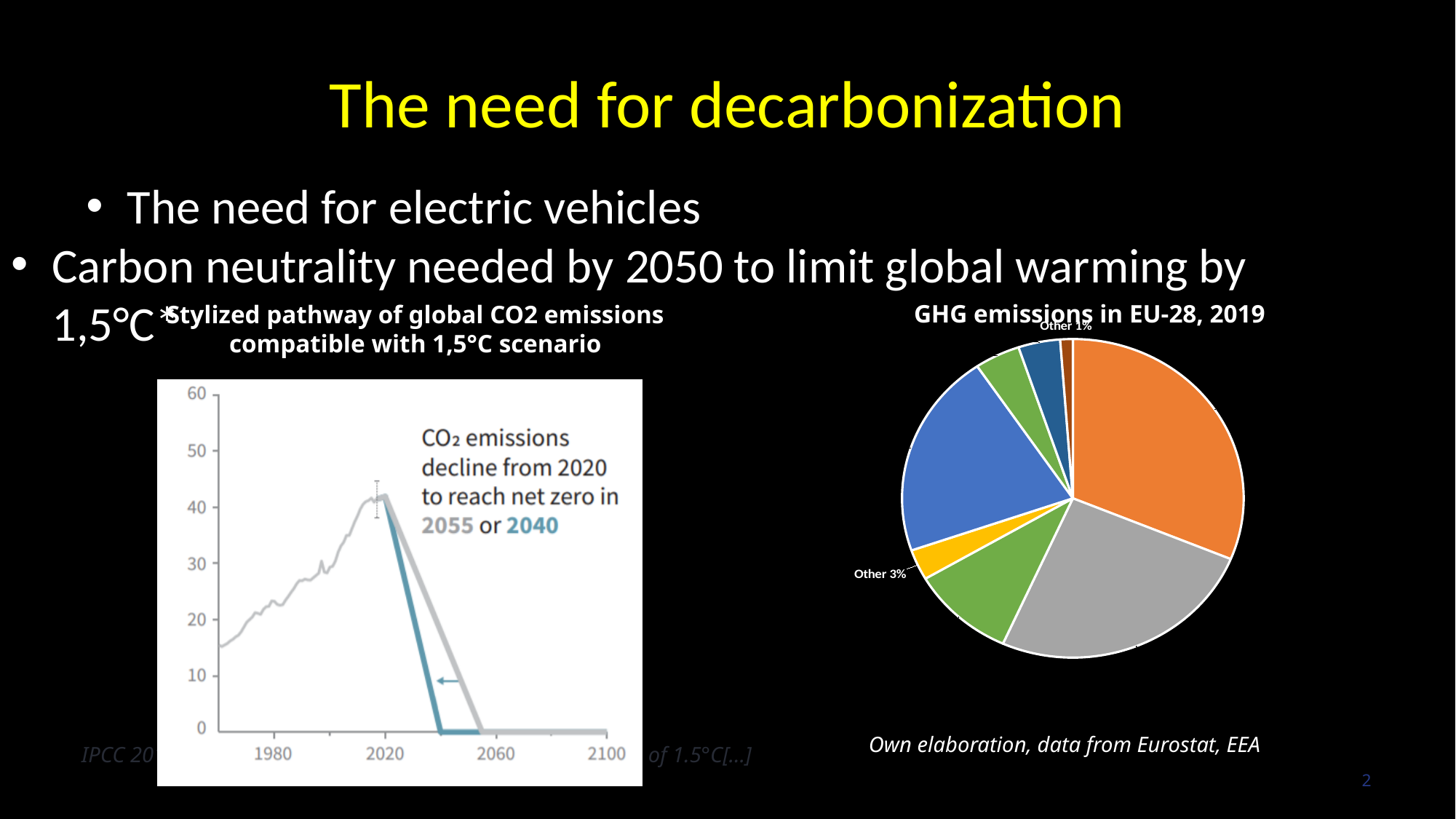
In the 'GHG emissions in EU-28, 2019' pie chart, what share does the slice labelled 'Other 1%' have? 1% In the 'GHG emissions in EU-28, 2019' pie chart, what share does the slice labelled 'Other 3%' have? 3% What kind of chart is the 'Stylized pathway of global CO2 emissions compatible with 1,5°C scenario' chart? line chart In the 'Stylized pathway of global CO2 emissions' chart, in which year does the grey pathway reach net zero? 2055 In the 'GHG emissions in EU-28, 2019' pie chart, which of the two labelled 'Other' slices is larger, the 1% one or the 3% one? Other 3% What kind of chart is the 'GHG emissions in EU-28, 2019' chart? pie chart In the 'Stylized pathway of global CO2 emissions' chart, in which year does the blue pathway reach net zero? 2040 In the 'GHG emissions in EU-28, 2019' pie chart, how many slices are there? 8 In the 'Stylized pathway of global CO2 emissions' chart, is the peak emissions value around 2020 greater or less than 30? greater In the 'Stylized pathway of global CO2 emissions' chart, what is the emissions value in 2100? 0 In the 'Stylized pathway of global CO2 emissions' chart, do emissions rise or fall after 2020? fall In the 'Stylized pathway of global CO2 emissions' chart, do emissions rise or fall between 1980 and 2020? rise